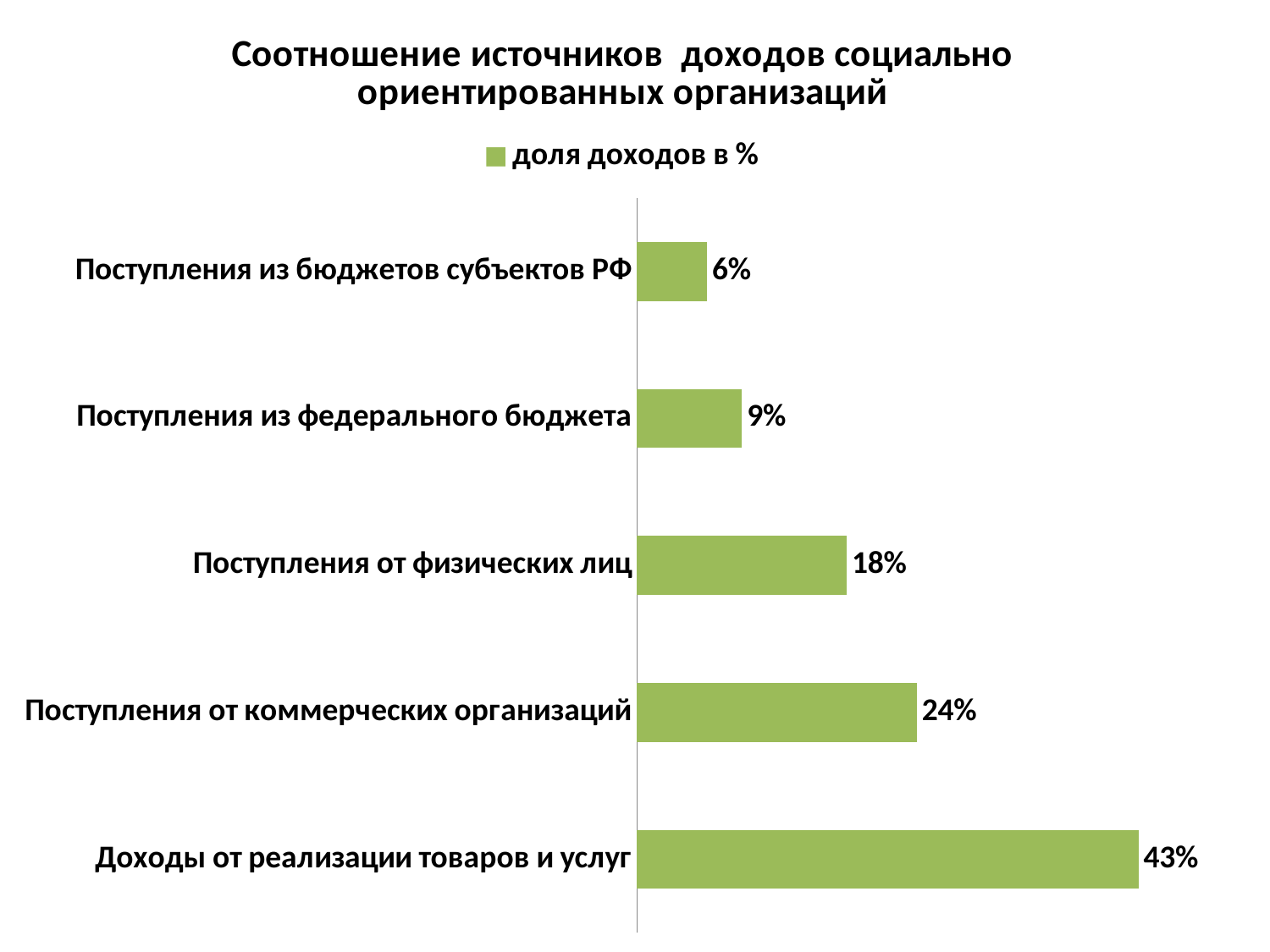
What is the value for Доходы от реализации товаров и услуг? 43% What is the difference between the values for Доходы от реализации товаров и услуг and Поступления от коммерческих организаций? 19% What is the legend entry of the series shown in the chart? доля доходов в % Which is larger: the value for Поступления от физических лиц or the value for Поступления из федерального бюджета? Поступления от физических лиц What is the value for Поступления от физических лиц? 18% What is the value for Поступления из бюджетов субъектов РФ? 6% Which category has the lowest value? Поступления из бюджетов субъектов РФ What is the value for Поступления из федерального бюджета? 9% What is the value for Поступления от коммерческих организаций? 24% How many categories are shown in the chart? 5 Which category has the highest value? Доходы от реализации товаров и услуг What kind of chart is shown on the slide? Bar chart